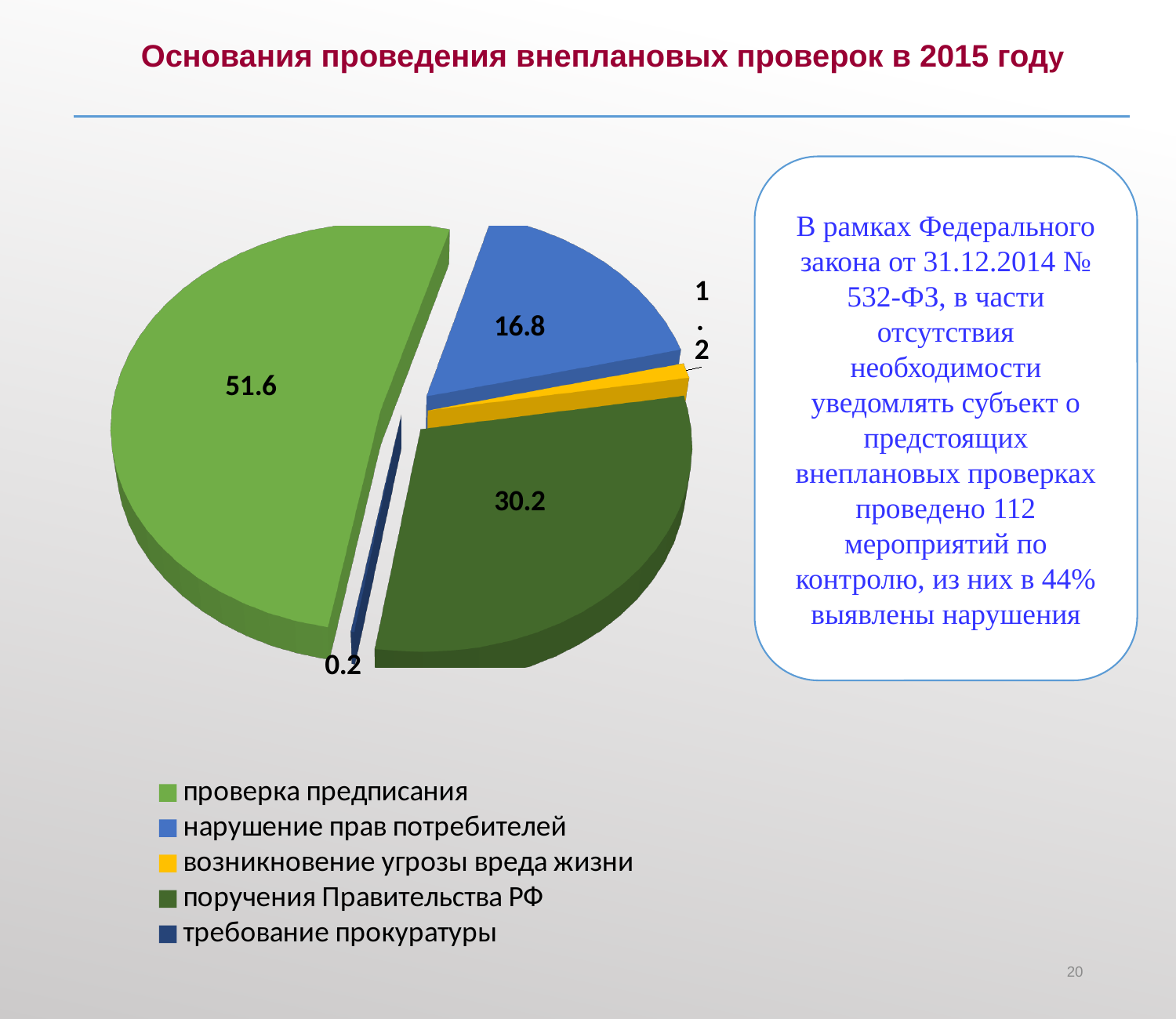
What is the value for требование прокуратуры? 0.2 Which category has the largest slice of the pie? проверка предписания Which is larger: нарушение прав потребителей or поручения Правительства РФ? поручения Правительства РФ What is the value for возникновение угрозы вреда жизни? 1.2 What is the difference between the values for проверка предписания and поручения Правительства РФ? 21.4 Which colour represents возникновение угрозы вреда жизни in the legend? yellow What is the value for поручения Правительства РФ? 30.2 What is the value for нарушение прав потребителей? 16.8 What kind of chart is shown on the slide? pie chart What is the value for проверка предписания? 51.6 Which category has the smallest slice of the pie? требование прокуратуры How many categories does the pie chart have? 5